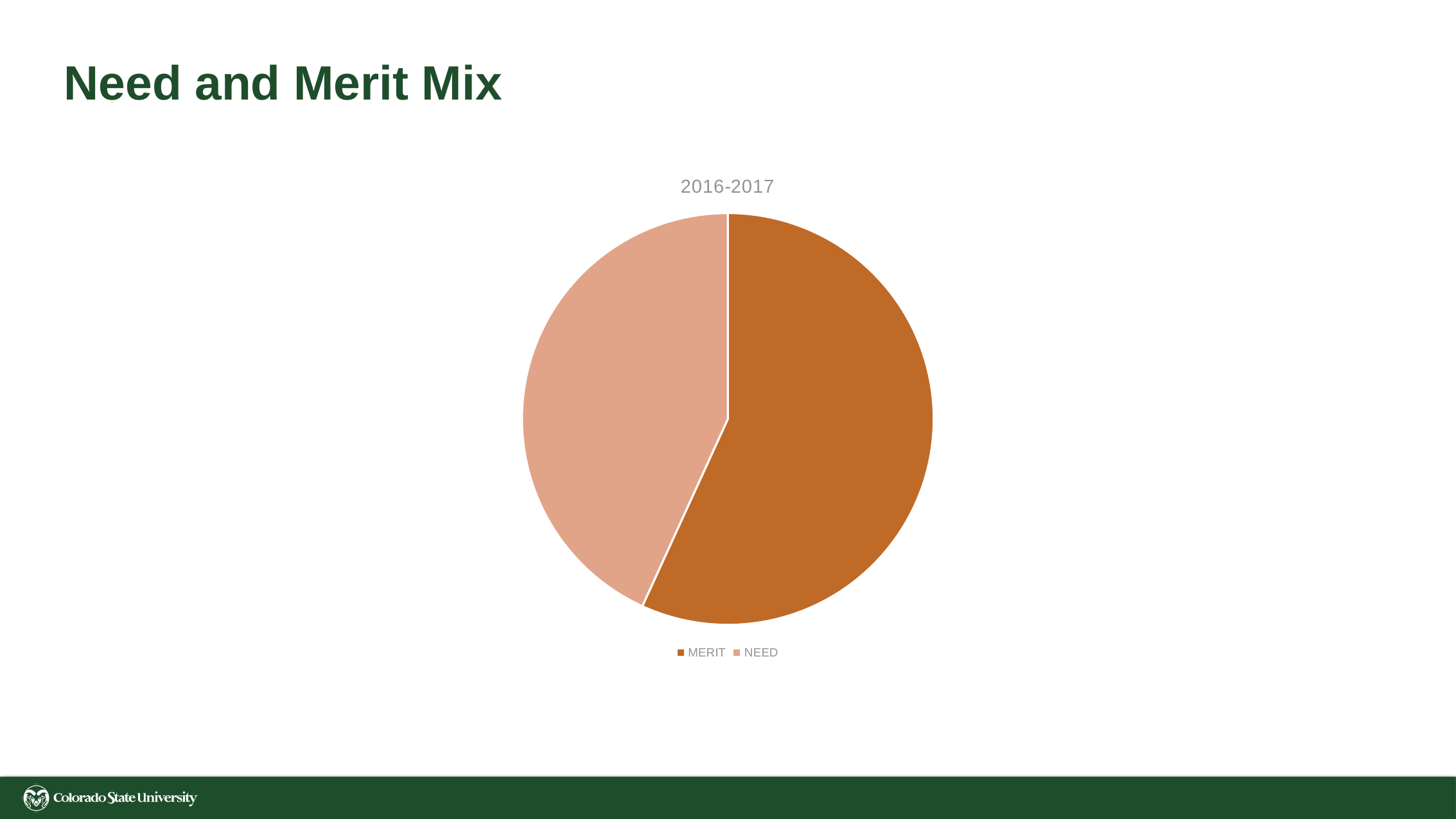
Which legend entry is shown in the darker orange colour? MERIT Which slice of the pie chart is the smallest? NEED Does the MERIT slice take up more or less than half of the pie? more Which is larger in the pie chart, MERIT or NEED? MERIT How many slices does the pie chart have? 2 What kind of chart is shown on the slide? pie chart How many entries does the legend of the pie chart list? 2 What is the title of the pie chart? 2016-2017 Which slice of the pie chart is the largest? MERIT